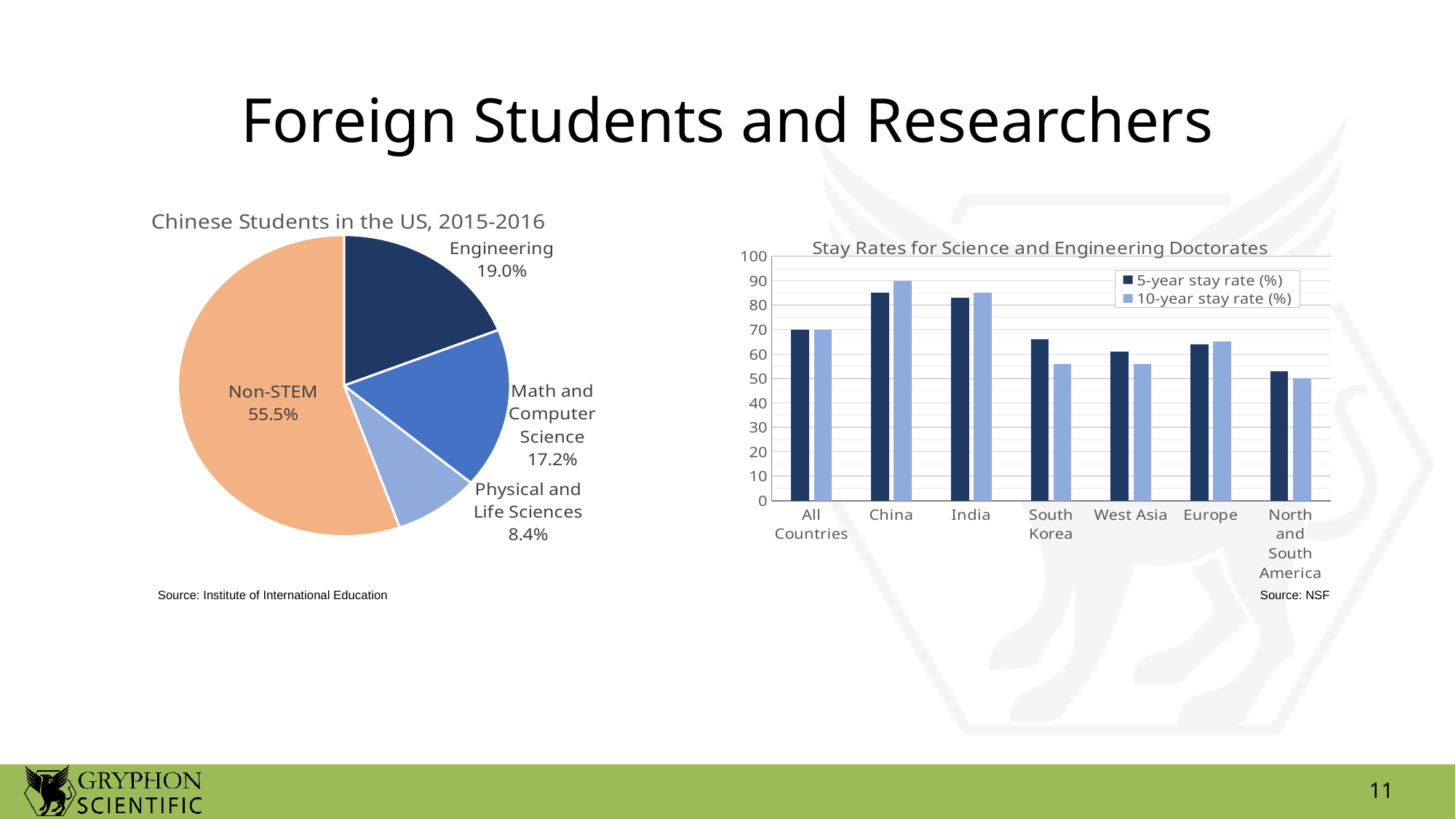
In the 'Chinese Students in the US, 2015-2016' chart, what is the difference in percentage points between Engineering and Math and Computer Science? 1.8 In the 'Stay Rates for Science and Engineering Doctorates' chart, is the 5-year stay rate for South Korea greater or less than 60? greater In the 'Chinese Students in the US, 2015-2016' chart, what percentage is shown for Engineering? 19.0% In the 'Stay Rates for Science and Engineering Doctorates' chart, how many series does the legend list? 2 What kind of chart is 'Stay Rates for Science and Engineering Doctorates'? Bar chart In the 'Chinese Students in the US, 2015-2016' chart, what share of Chinese students are in Non-STEM fields? 55.5% In the 'Chinese Students in the US, 2015-2016' chart, how many slices does the pie have? 4 In the 'Stay Rates for Science and Engineering Doctorates' chart, which region has the highest 10-year stay rate? China In the 'Chinese Students in the US, 2015-2016' chart, which slice is the smallest? Physical and Life Sciences In the 'Stay Rates for Science and Engineering Doctorates' chart, how many regions are shown on the x axis? 7 In the 'Chinese Students in the US, 2015-2016' chart, what percentage is shown for Physical and Life Sciences? 8.4% What kind of chart is 'Chinese Students in the US, 2015-2016'? Pie chart